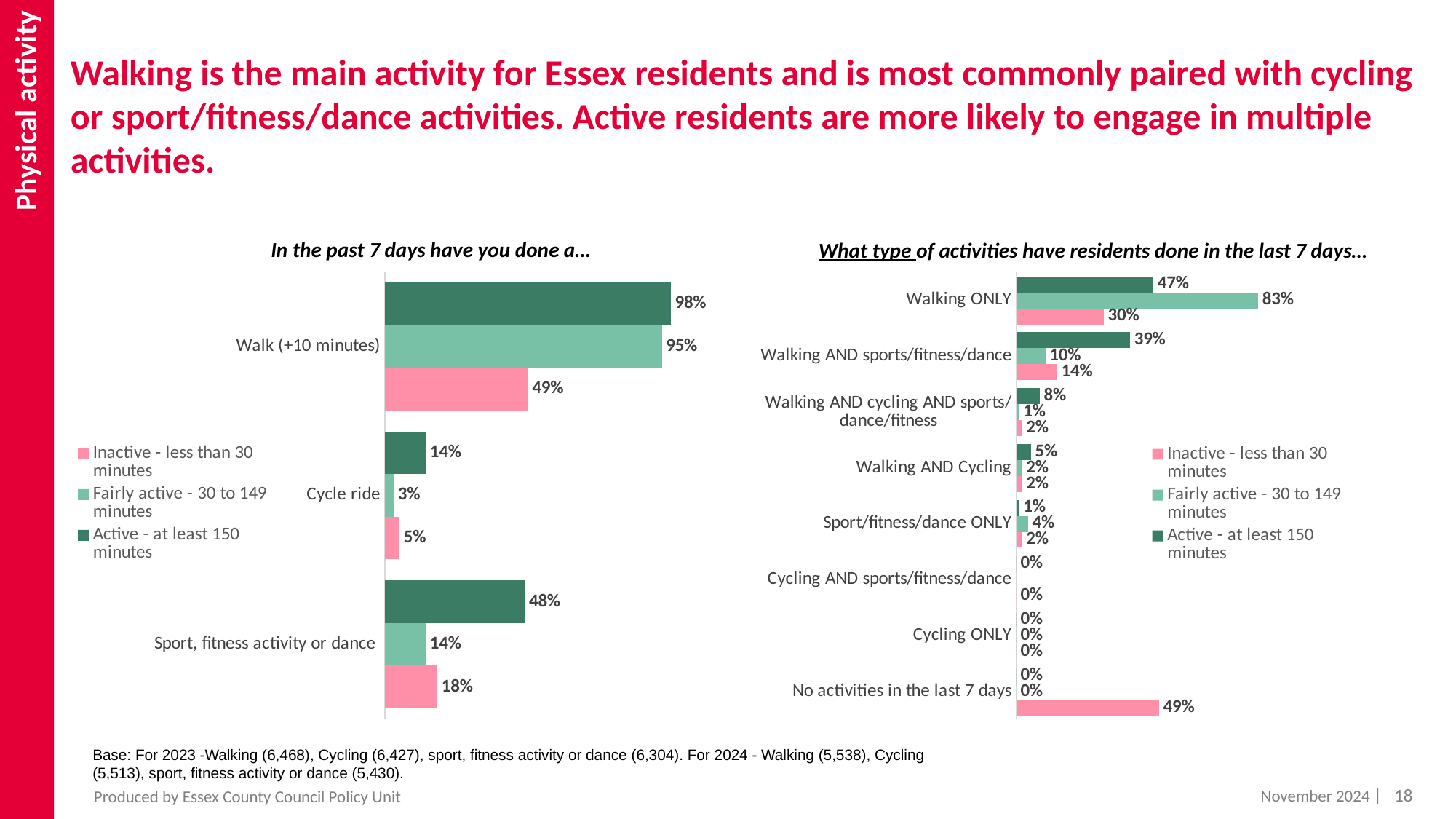
In the left chart 'In the past 7 days have you done a...', what is the value for Walk (+10 minutes) among Active residents (at least 150 minutes)? 98% In the right chart 'What type of activities have residents done in the last 7 days...', which is larger for Walking ONLY: the Active value or the Inactive value? Active What kind of chart is the left chart 'In the past 7 days have you done a...'? Bar chart In the right chart 'What type of activities have residents done in the last 7 days...', how many activity categories are shown? 8 In the left chart 'In the past 7 days have you done a...', what is the difference between the Active and Inactive values for Walk (+10 minutes)? 49 percentage points In the left chart 'In the past 7 days have you done a...', what is the value for Cycle ride among Fairly active residents (30 to 149 minutes)? 3% In the left chart 'In the past 7 days have you done a...', how many series does the legend list? 3 In the right chart 'What type of activities have residents done in the last 7 days...', what is the value for Walking AND sports/fitness/dance among Active residents? 39% In the left chart 'In the past 7 days have you done a...', which activity has the lowest value for Active residents? Cycle ride In the right chart 'What type of activities have residents done in the last 7 days...', what is the value for Walking ONLY among Fairly active residents? 83% In the left chart 'In the past 7 days have you done a...', what is the value for Sport, fitness activity or dance among Inactive residents (less than 30 minutes)? 18% In the right chart 'What type of activities have residents done in the last 7 days...', what is the value for No activities in the last 7 days among Inactive residents? 49%